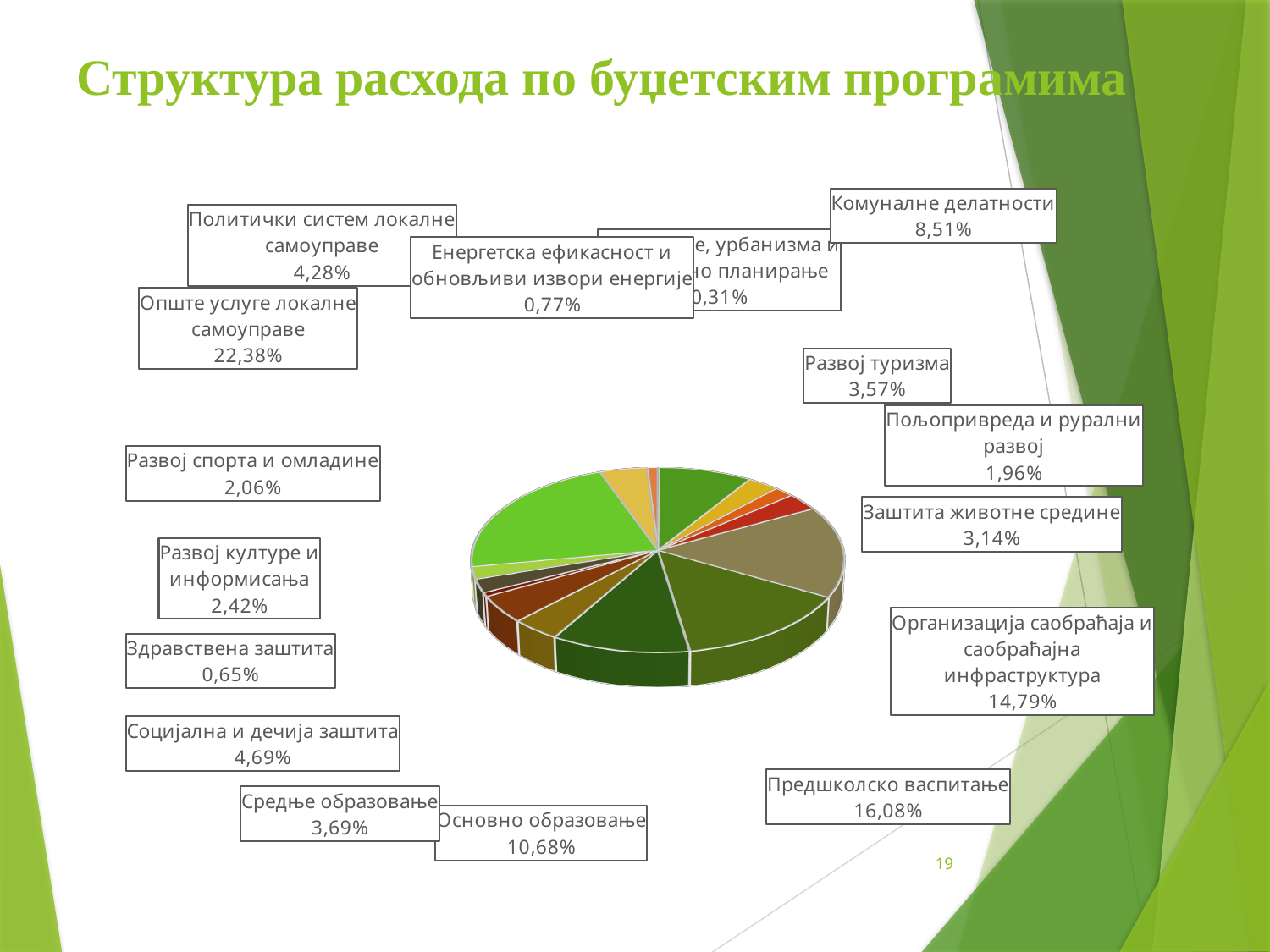
What is the value for Организација саобраћаја и саобраћајна инфраструктура? 14,79% What is the difference between the shares for Предшколско васпитање and Основно образовање? 5,40% Which is larger, the share for Развој туризма or for Заштита животне средине? Развој туризма Which budget programme has the largest share of expenditure? Опште услуге локалне самоуправе Which is larger, the share for Основно образовање or for Средње образовање? Основно образовање What is the value shown for Комуналне делатности? 8,51% What share of expenditure goes to Опште услуге локалне самоуправе? 22,38% What is the title of the chart on the slide? Структура расхода по буџетским програмима What percentage is labelled for Здравствена заштита? 0,65% What is the difference between the shares for Опште услуге локалне самоуправе and Предшколско васпитање? 6,30% What type of chart is shown on the slide? pie chart What percentage is shown for Предшколско васпитање? 16,08%